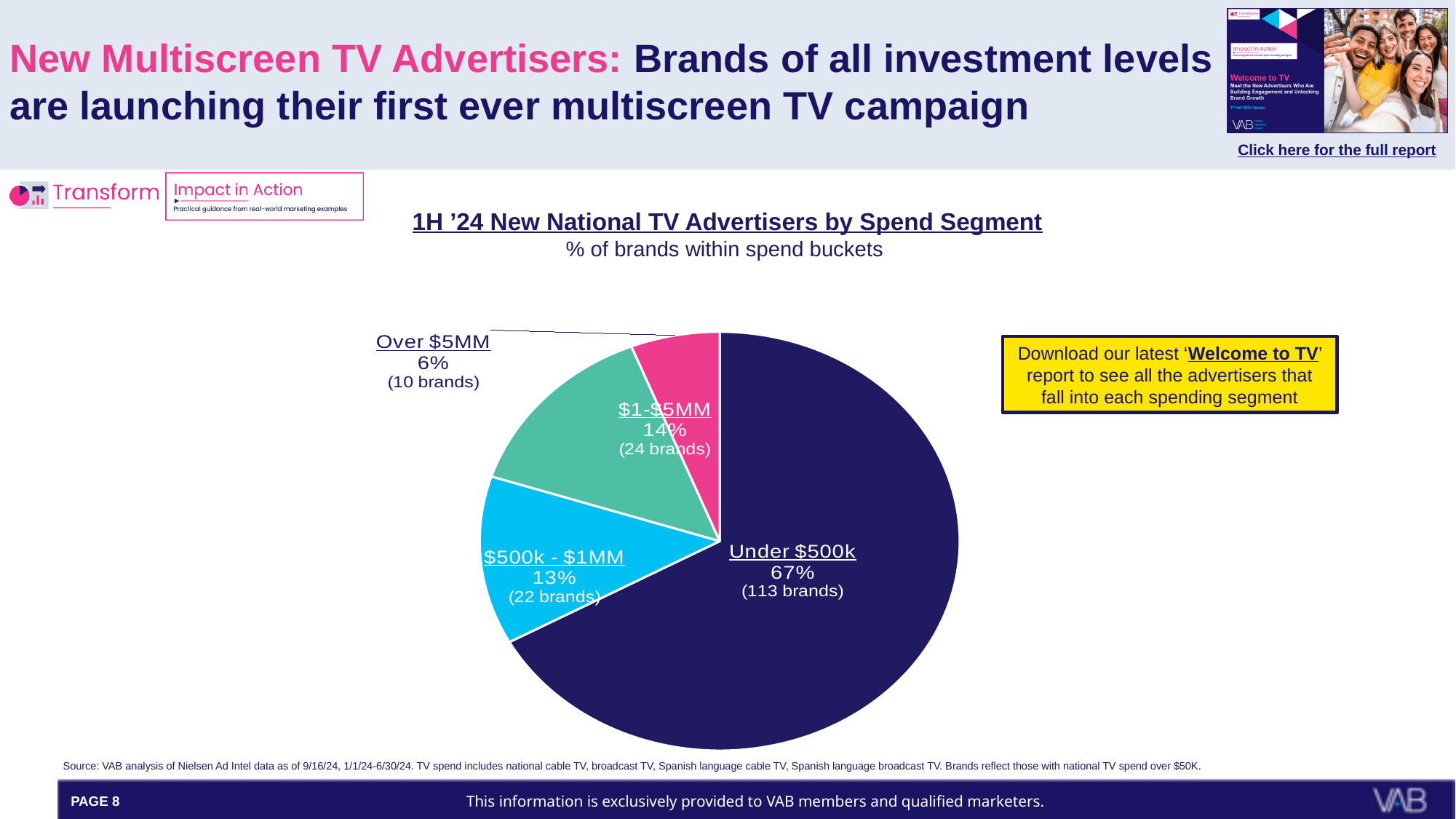
What kind of chart is shown on the slide? pie chart Which spend segment has the smallest share of brands? Over $5MM How many spend segments does the pie chart show? 4 Which spend segment has the largest share of brands? Under $500k Which segment has more brands, $500k - $1MM or Over $5MM? $500k - $1MM What is the difference in percentage points between the Under $500k segment and the $1-$5MM segment? 53 What is the total number of brands across all four spend segments? 169 What percentage of brands fall in the Under $500k segment? 67% How many brands are in the $1-$5MM segment? 24 brands How many brands are in the $500k - $1MM segment? 22 brands What is the title of the chart? 1H '24 New National TV Advertisers by Spend Segment What percentage of brands fall in the Over $5MM segment? 6%